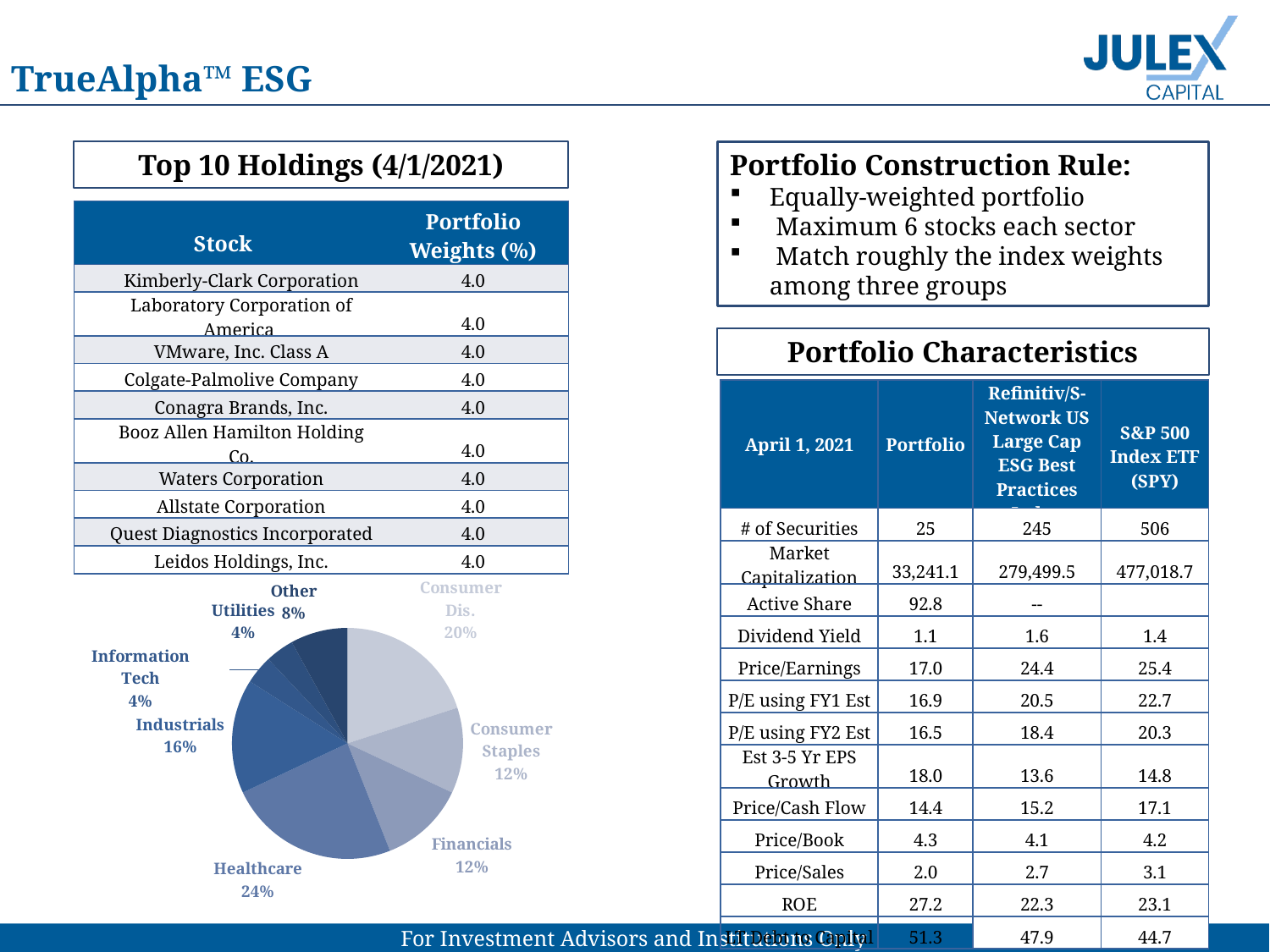
What type of chart is shown on the slide? pie chart What is the difference between the Healthcare and Industrials shares in the pie chart? 8% Which is larger in the pie chart, Consumer Dis. or Consumer Staples? Consumer Dis. Which sector has the largest slice in the pie chart? Healthcare Which is larger in the pie chart, Industrials or Other? Industrials What share of the pie chart does Other represent? 8% What share of the pie chart does Consumer Dis. represent? 20% What share of the pie chart does Healthcare represent? 24% What share of the pie chart does Industrials represent? 16% How many slices does the pie chart have? 8 What share of the pie chart does Utilities represent? 4% What is the combined share of Financials and Consumer Staples in the pie chart? 24%